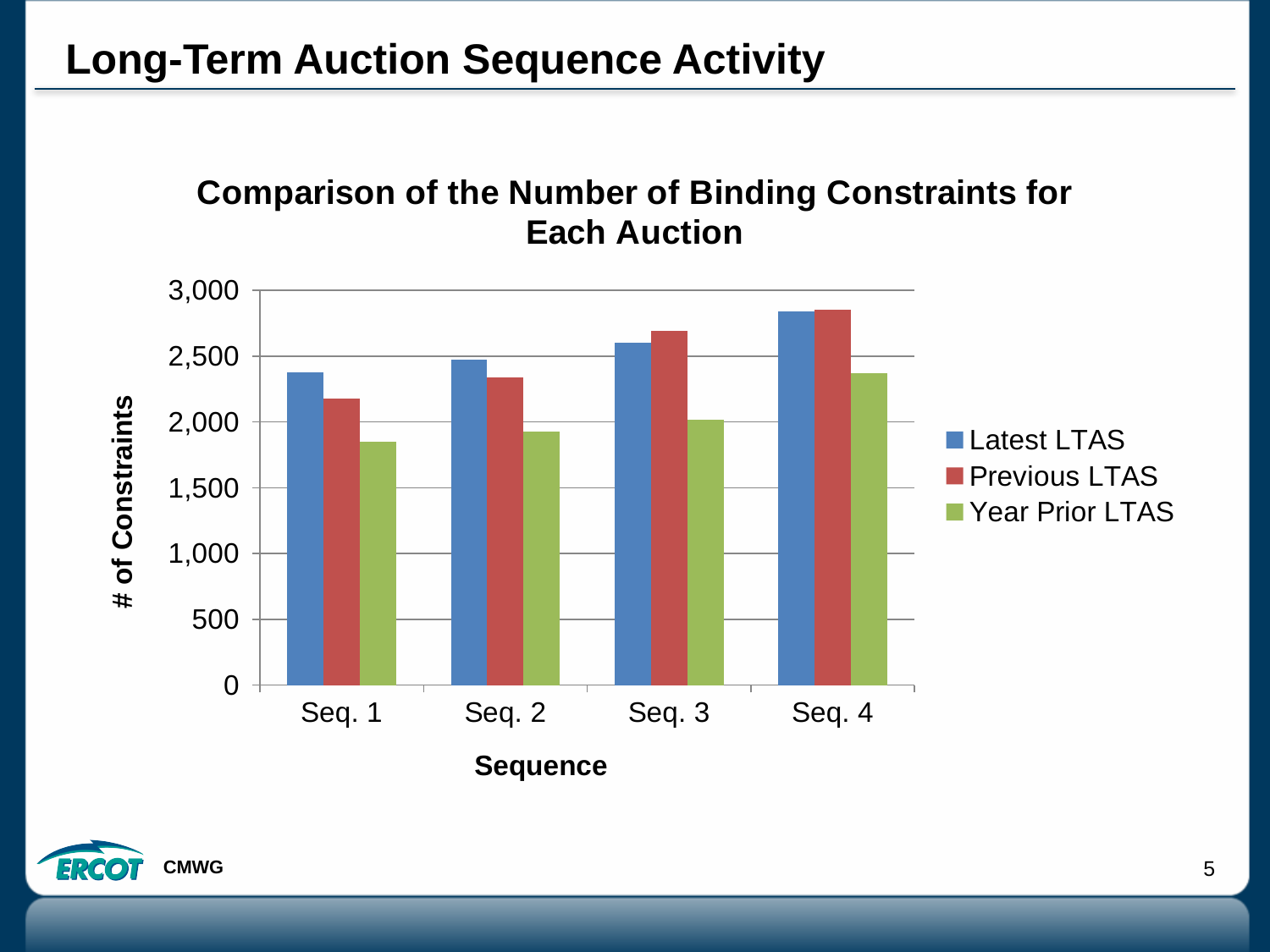
What is the label of the y axis? # of Constraints Which sequence has the highest Year Prior LTAS value? Seq. 4 Is the Year Prior LTAS value for Seq. 1 greater or less than 2,000? less Which sequence has the lowest Latest LTAS value? Seq. 1 Which sequence has the lowest Previous LTAS value? Seq. 1 For Seq. 1, which is larger: Latest LTAS or Previous LTAS? Latest LTAS How many series does the legend list? 3 What kind of chart is shown on the slide? bar chart Do the Latest LTAS values rise or fall from Seq. 1 to Seq. 4? rise How many sequence categories are shown on the x axis? 4 For Seq. 2, which is larger: Previous LTAS or Year Prior LTAS? Previous LTAS Is the Latest LTAS value for Seq. 3 greater or less than 2,500? greater